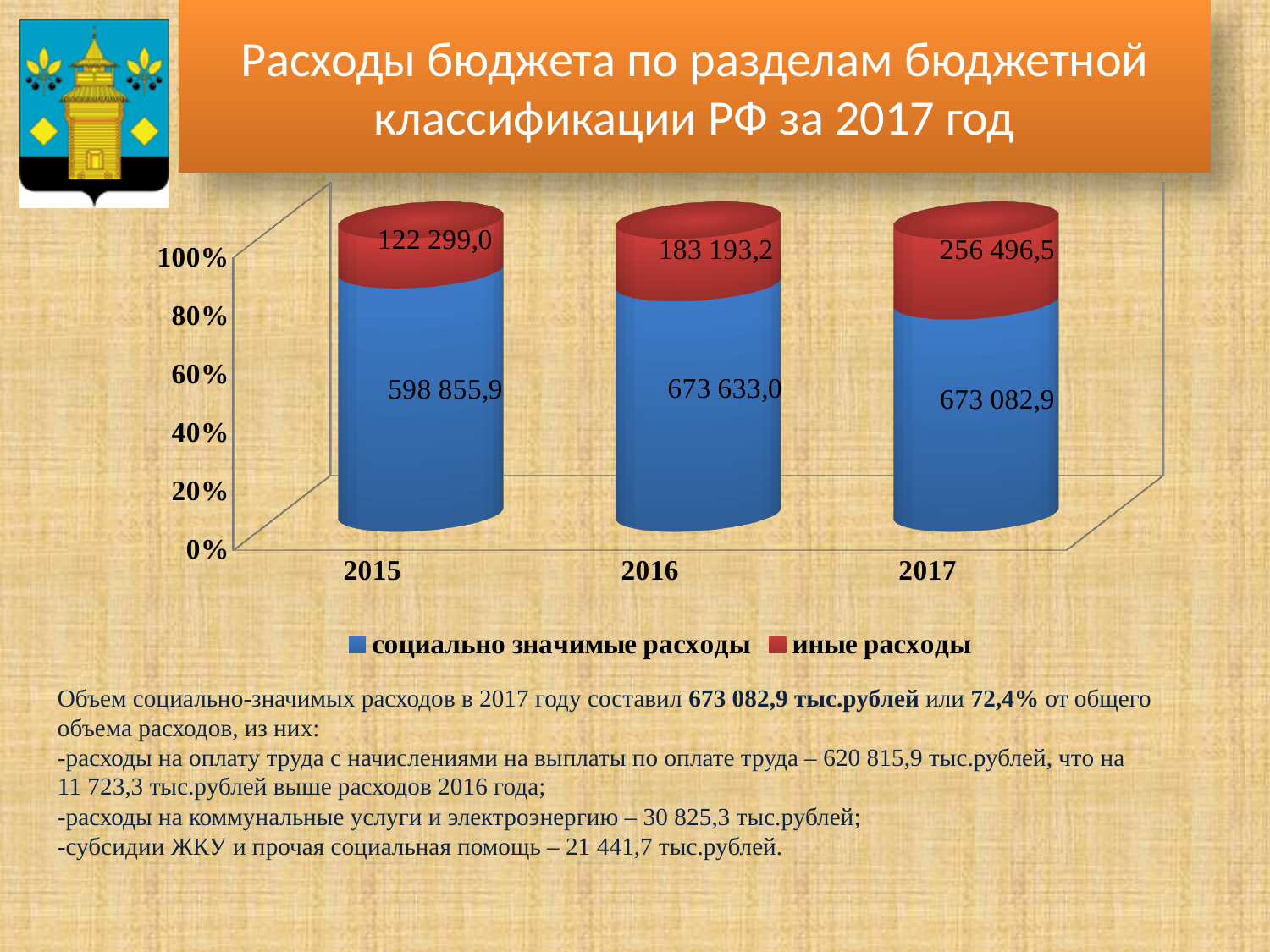
In which year is the value for социально значимые расходы the lowest? 2015 How many years are shown on the x axis? 3 What is the difference between иные расходы in 2017 and in 2015? 134 197,5 What kind of chart is shown on the slide? Stacked bar chart What is the total of the stacked bar for 2015? 721 154,9 What is the value for иные расходы in 2016? 183 193,2 How many series does the legend list? 2 In which year is the value for иные расходы the highest? 2017 Which is larger: социально значимые расходы in 2016 or in 2015? 2016 Do the values for иные расходы rise or fall from 2015 to 2017? Rise What is the value for социально значимые расходы in 2015? 598 855,9 What is the value for иные расходы in 2017? 256 496,5